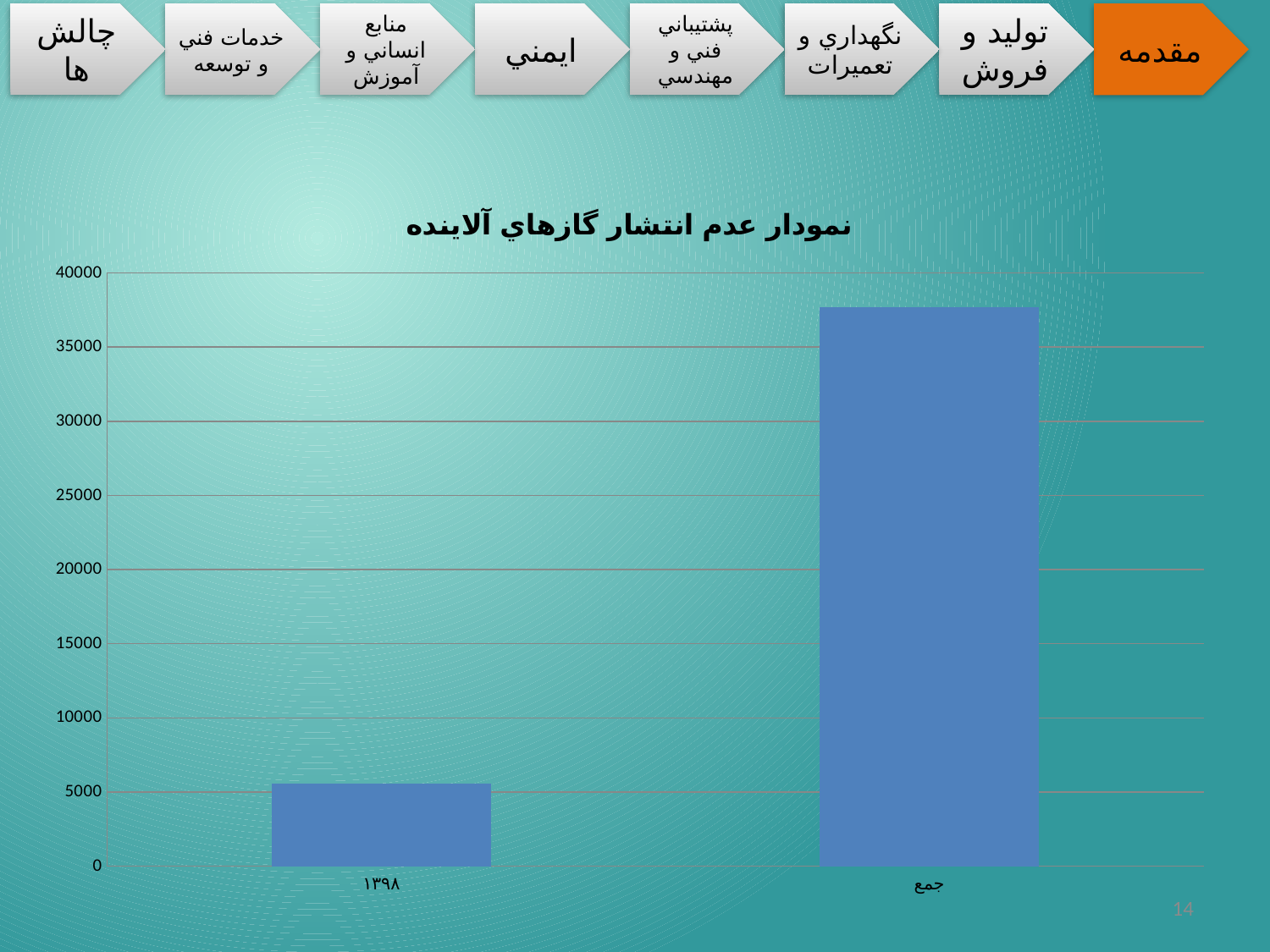
How many categories are shown on the x axis of the chart? 2 Is the value for ۱۳۹۸ greater or less than 5000? greater Is the value for جمع greater or less than 40000? less What kind of chart is shown on the slide? bar chart What is the highest value shown on the vertical axis of the chart? 40000 Which category has the highest bar in the chart? جمع Is the value for ۱۳۹۸ greater or less than 10000? less Which is larger, the value for ۱۳۹۸ or the value for جمع? جمع What is the title of the chart? نمودار عدم انتشار گازهاي آلاينده Which category has the lowest bar in the chart? ۱۳۹۸